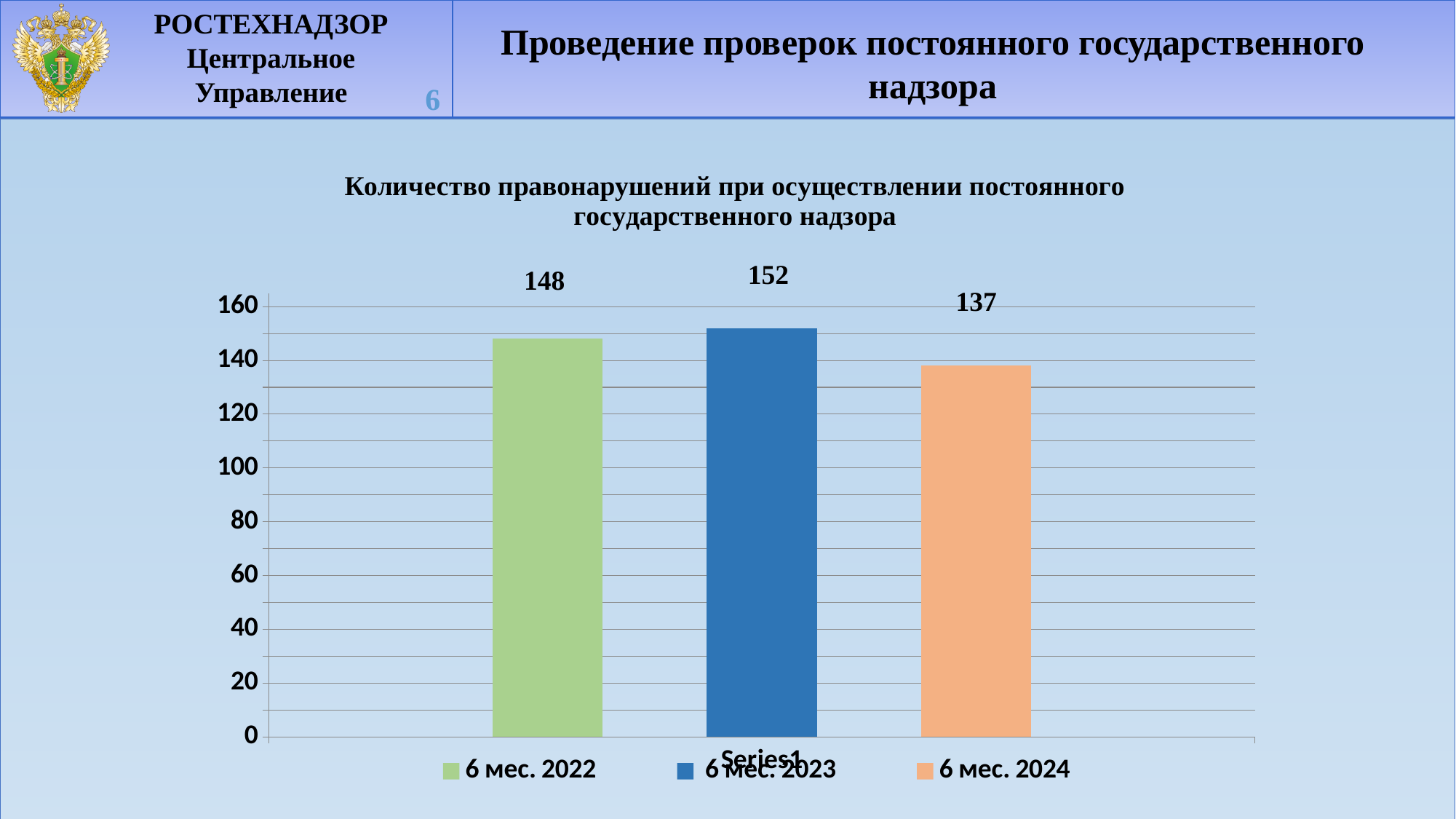
What is the difference between the values for 6 мес. 2022 and 6 мес. 2024? 11 Which is larger, the value for 6 мес. 2022 or the value for 6 мес. 2024? 6 мес. 2022 What is the difference between the values for 6 мес. 2023 and 6 мес. 2024? 15 Which period has the highest value? 6 мес. 2023 What kind of chart is shown on the slide? bar chart What is the value for 6 мес. 2023? 152 How many series does the legend list? 3 Which period has the lowest value? 6 мес. 2024 What is the value for 6 мес. 2024? 137 What is the title of the chart? Количество правонарушений при осуществлении постоянного государственного надзора Is the value for 6 мес. 2024 greater or less than 140? less What is the value for 6 мес. 2022? 148